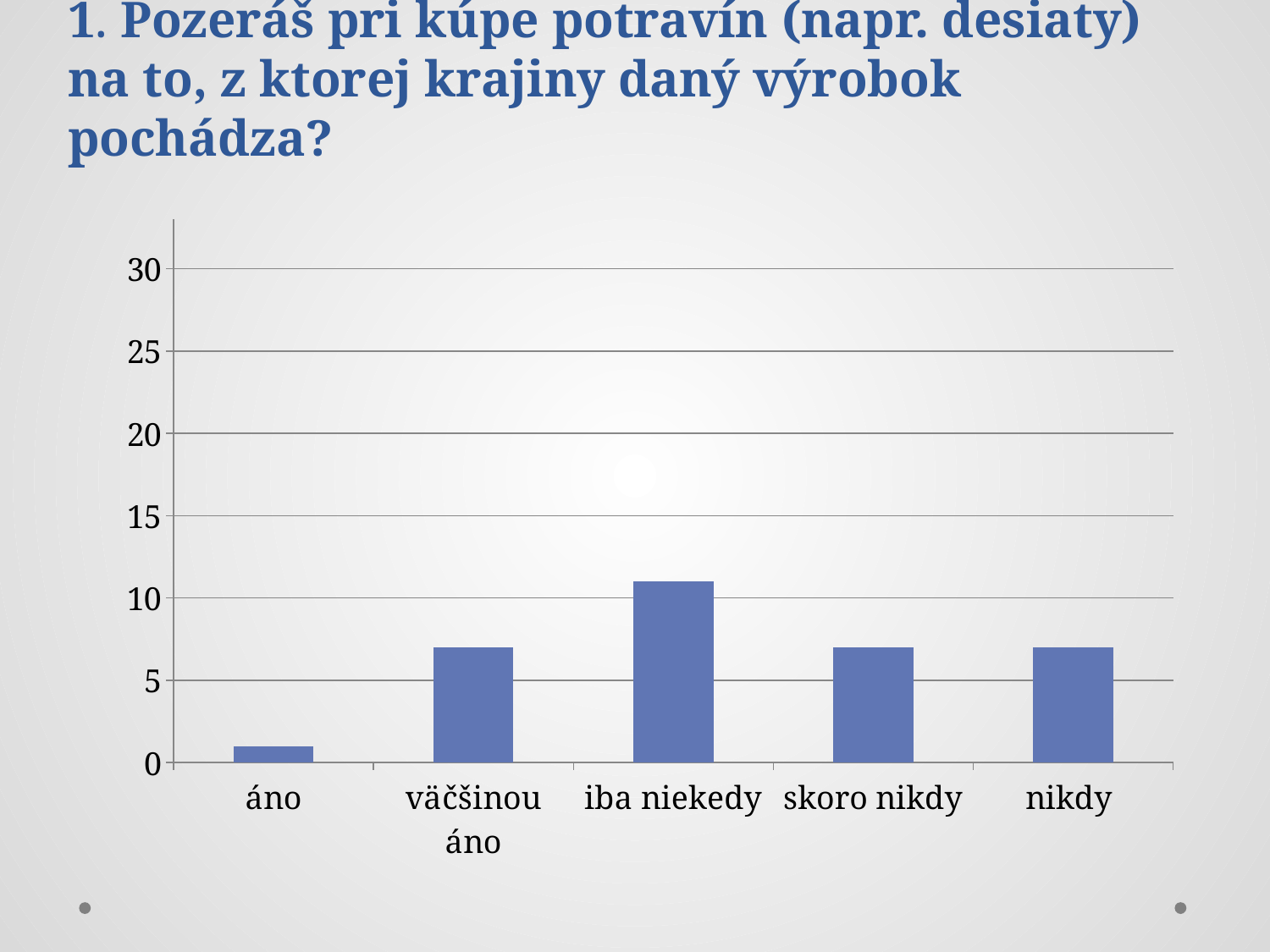
Which is larger, the value for iba niekedy or the value for väčšinou áno? iba niekedy Which category has the highest bar in the chart? iba niekedy Which category has the lowest bar in the chart? áno What is the highest value shown on the vertical axis of the chart? 30 Which is larger, the value for áno or the value for nikdy? nikdy Is the value for väčšinou áno greater or less than 5? greater Is the value for skoro nikdy greater or less than 15? less Is the value for áno greater or less than 5? less What kind of chart is shown on the slide? bar chart How many categories are shown on the x axis of the chart? 5